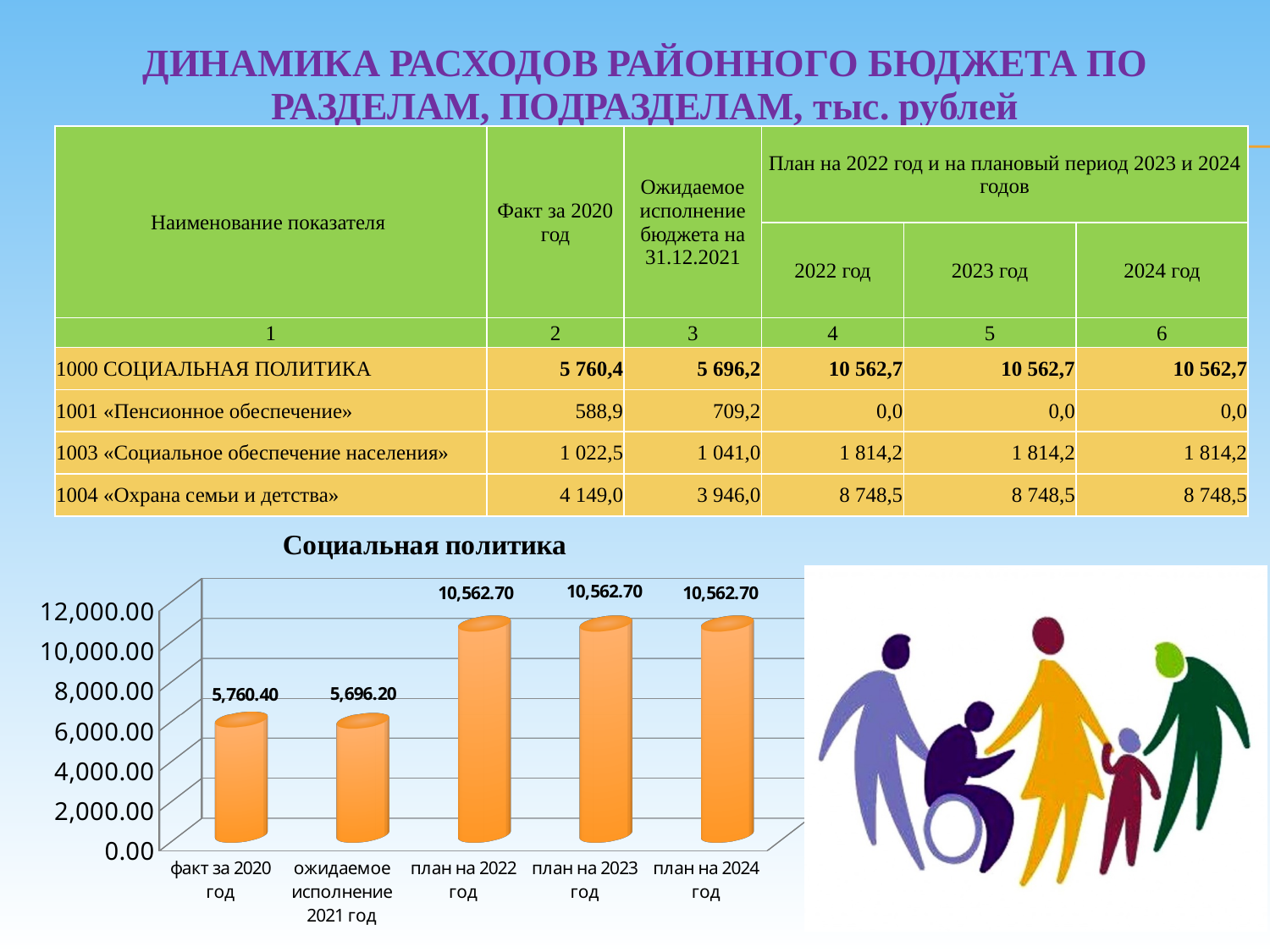
In the "Социальная политика" chart, is the value for "план на 2022 год" greater or less than 10,000.00? greater What is the value for "факт за 2020 год" in the "Социальная политика" chart? 5,760.40 What is the value for "план на 2024 год" in the "Социальная политика" chart? 10,562.70 In the "Социальная политика" chart, which is larger: the value for "план на 2023 год" or the value for "факт за 2020 год"? план на 2023 год What is the title of the chart on the slide? Социальная политика What type of chart is shown under the title "Социальная политика"? bar chart What is the value for "ожидаемое исполнение 2021 год" in the "Социальная политика" chart? 5,696.20 Which category has the lowest value in the "Социальная политика" chart? ожидаемое исполнение 2021 год What is the value for "план на 2022 год" in the "Социальная политика" chart? 10,562.70 In the "Социальная политика" chart, what is the difference between the value for "план на 2022 год" and the value for "факт за 2020 год"? 4,802.30 How many bars are plotted in the "Социальная политика" chart? 5 In the "Социальная политика" chart, what is the difference between the value for "факт за 2020 год" and the value for "ожидаемое исполнение 2021 год"? 64.20